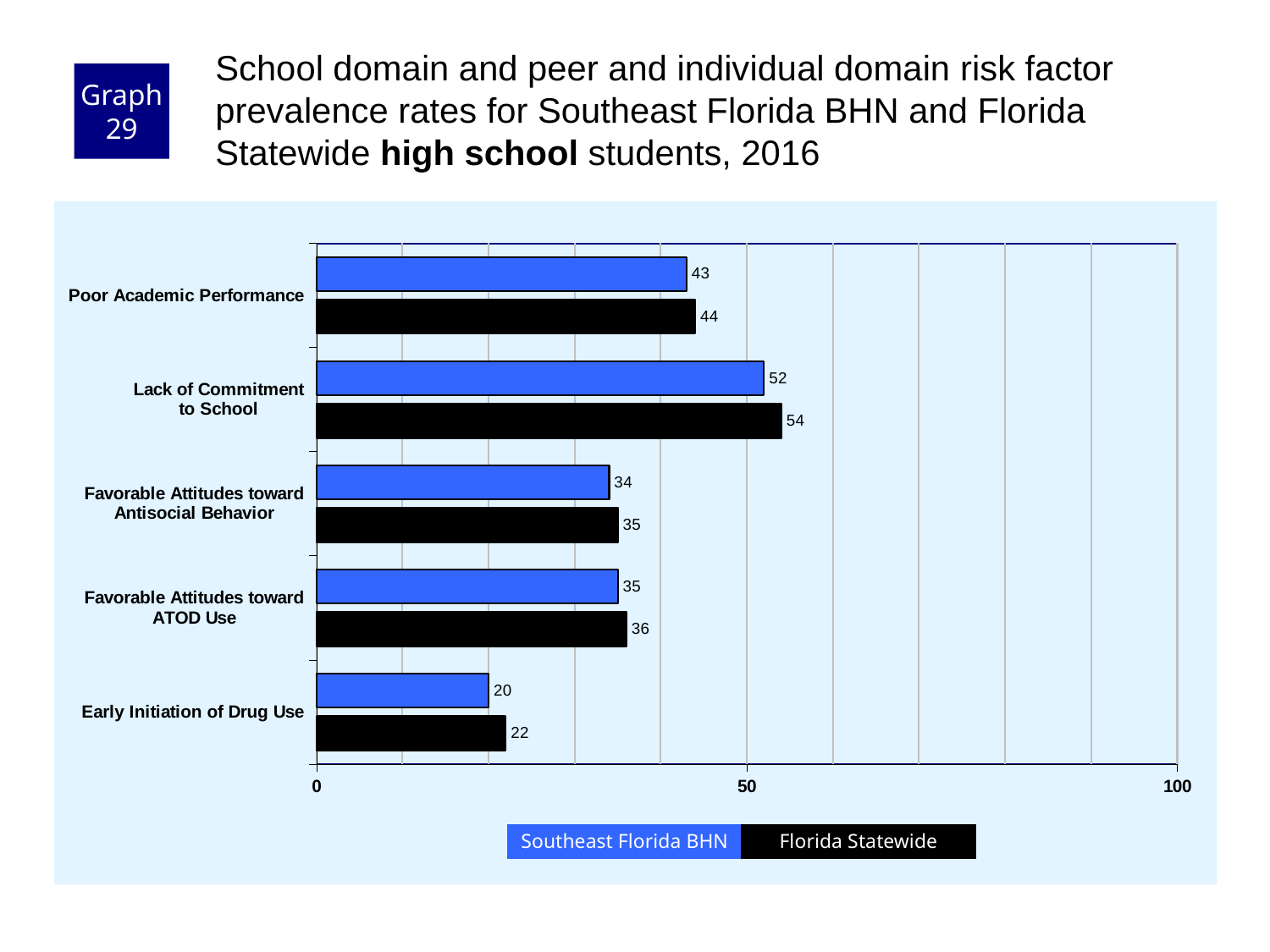
Which is larger: the Southeast Florida BHN value for Poor Academic Performance or for Favorable Attitudes toward ATOD Use? Poor Academic Performance What is the Southeast Florida BHN value for Lack of Commitment to School? 52 How many risk factor categories are shown on the chart? 5 Which risk factor has the lowest Southeast Florida BHN value? Early Initiation of Drug Use What kind of chart is shown on the slide? bar chart What is the difference between the Southeast Florida BHN values for Poor Academic Performance and Early Initiation of Drug Use? 23 What is the Florida Statewide value for Poor Academic Performance? 44 Which risk factor has the highest Florida Statewide value? Lack of Commitment to School Is the Florida Statewide value for Lack of Commitment to School greater or less than 50? greater What is the difference between the Florida Statewide and Southeast Florida BHN values for Lack of Commitment to School? 2 What is the Florida Statewide value for Early Initiation of Drug Use? 22 How many series does the legend list? 2